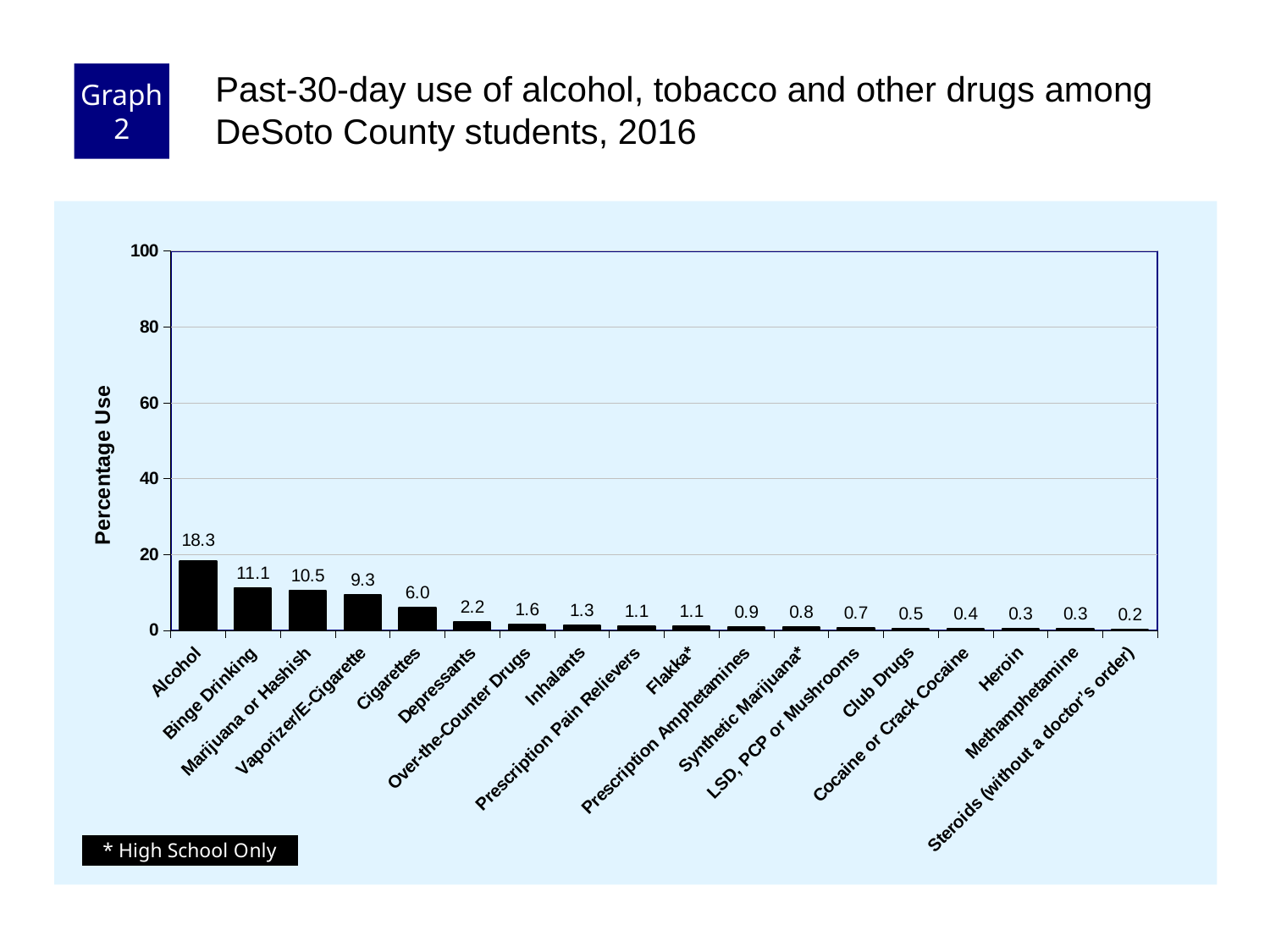
What is the percentage use for Alcohol? 18.3 What is the percentage use for Vaporizer/E-Cigarette? 9.3 Which category has the highest percentage use? Alcohol What is the difference in percentage use between Cigarettes and Depressants? 3.8 What is the label of the y axis? Percentage Use What is the difference in percentage use between Alcohol and Binge Drinking? 7.2 What is the percentage use for Heroin? 0.3 Is the value for Alcohol greater or less than 20? less Which category has the lowest percentage use? Steroids (without a doctor's order) How many categories are shown on the x axis? 18 Which has a higher percentage use, Marijuana or Hashish or Cigarettes? Marijuana or Hashish What kind of chart is shown on the slide? bar chart